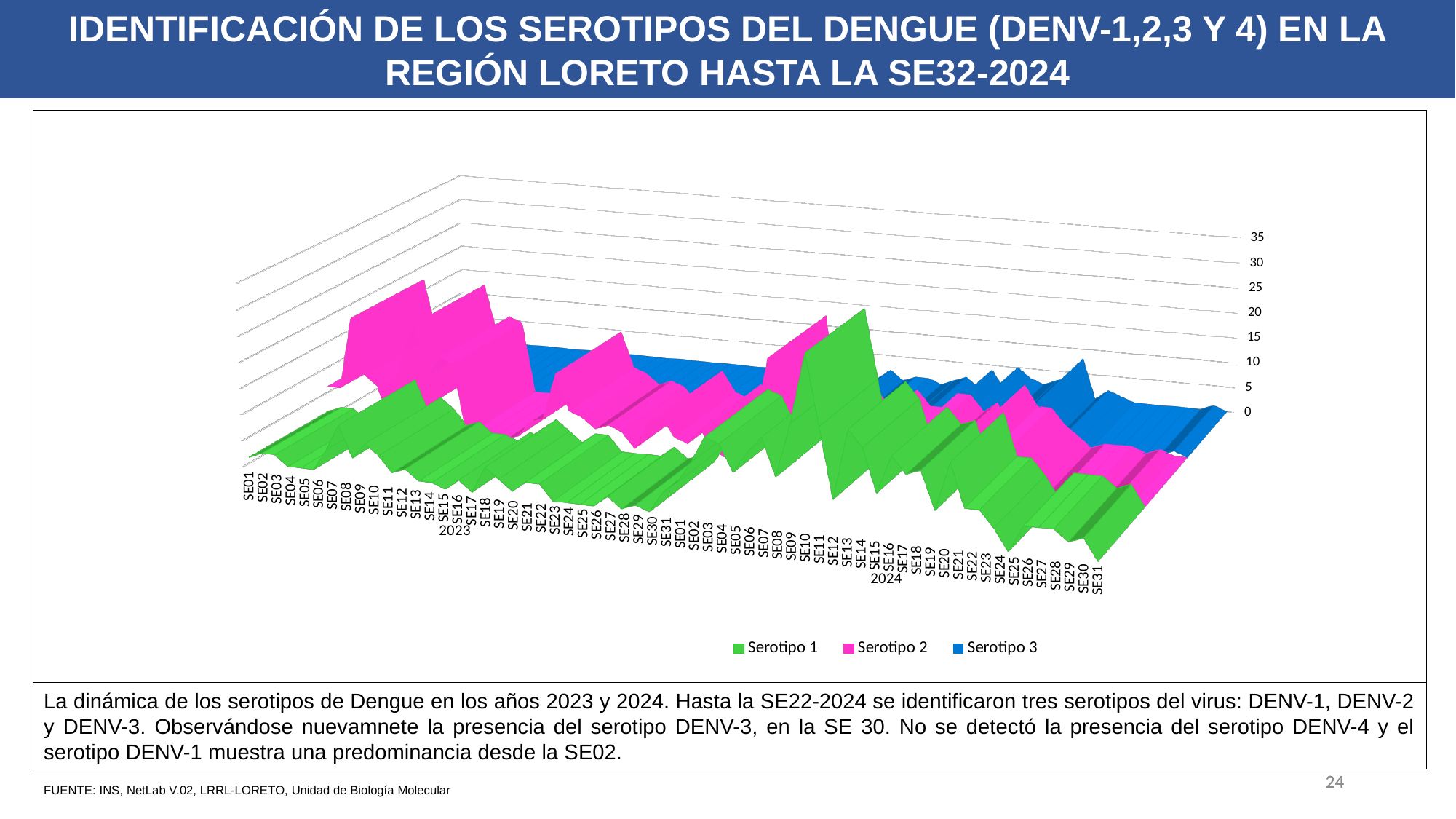
How many years are labelled along the x axis of the chart? 2 How many series does the legend list? 3 What are the three series named in the legend? Serotipo 1, Serotipo 2, Serotipo 3 What is the last week label on the x axis for 2024? SE31 What is the highest value shown on the vertical axis of the chart? 35 What is the first week label on the x axis for 2023? SE01 What kind of chart is shown on the slide? 3D line chart How many week categories are plotted in total across 2023 and 2024? 62 How many epidemiological weeks (SE) are labelled on the x axis for 2024? 31 Which colour represents Serotipo 2 in the chart? pink